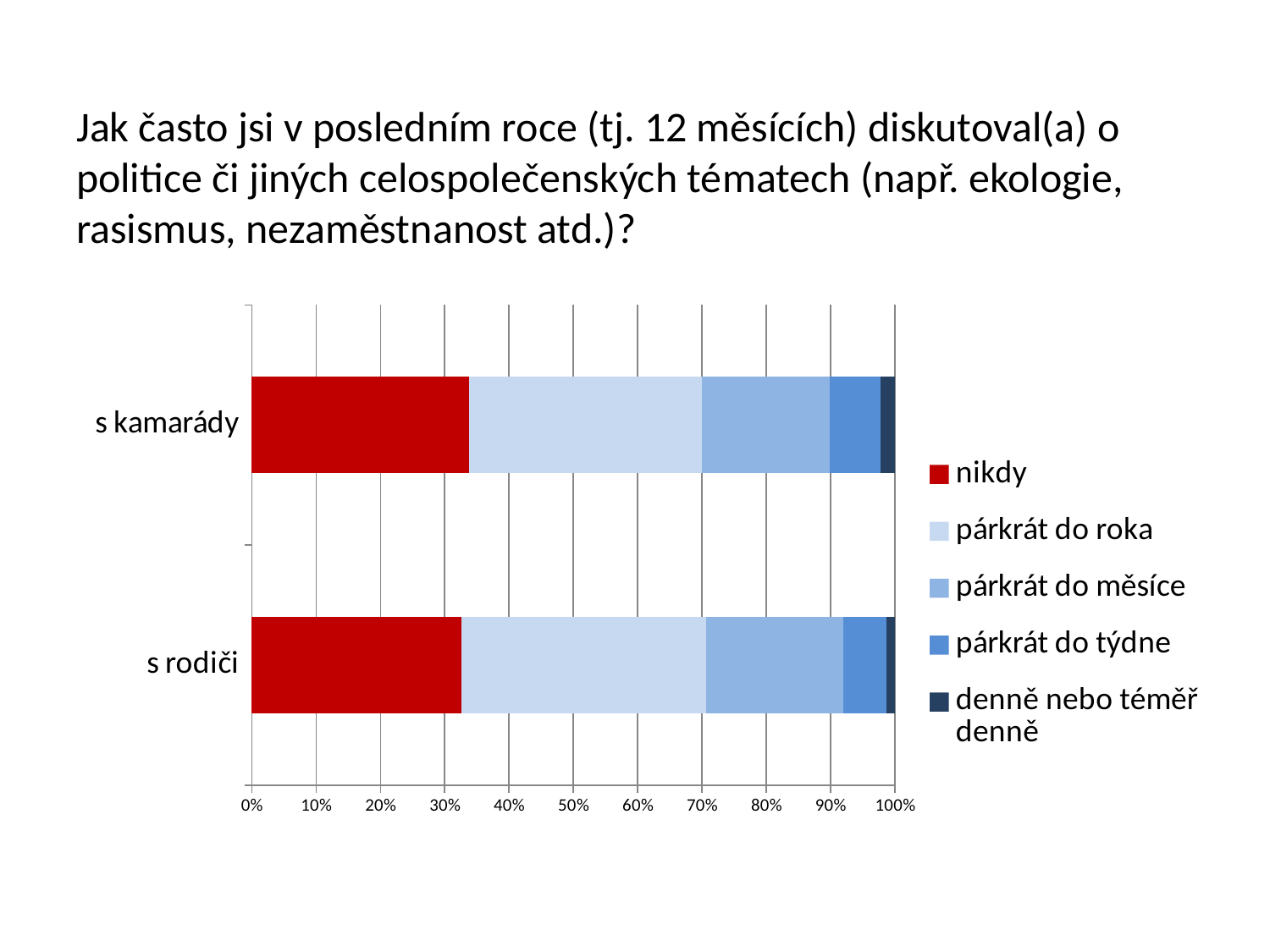
Is the 'nikdy' value for 's rodiči' greater or less than 40%? less For 's kamarády', which is larger: 'párkrát do roka' or 'párkrát do měsíce'? párkrát do roka Which series has the smallest share in the 's kamarády' bar? denně nebo téměř denně For 's rodiči', which is larger: 'nikdy' or 'párkrát do měsíce'? nikdy What kind of chart is shown on the slide? stacked bar chart How many series does the legend list? 5 Is the 'denně nebo téměř denně' value for 's rodiči' greater or less than 10%? less Which series is listed first in the legend? nikdy How many categories (bars) does the chart show? 2 Which colour represents the 'nikdy' series? red Is the 'nikdy' value for 's kamarády' greater or less than 30%? greater